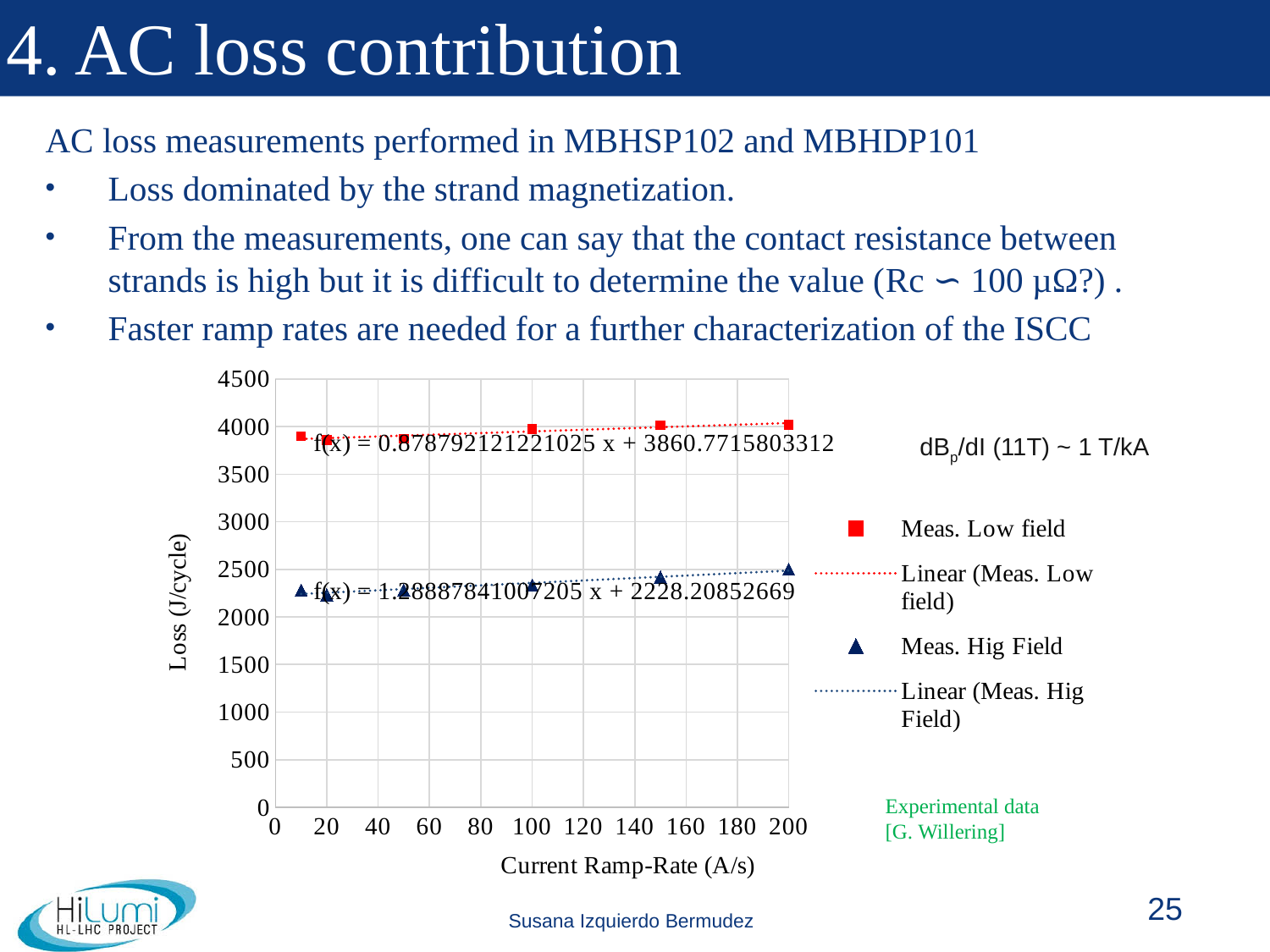
At a current ramp-rate of 200 A/s, which series has the higher loss, Meas. Low field or Meas. Hig Field? Meas. Low field What kind of chart is shown on the slide? scatter chart Do the Meas. Hig Field values rise or fall as the current ramp-rate increases? rise What is the title of the y axis of the chart? Loss (J/cycle) Is the Meas. Low field value at a current ramp-rate of 100 A/s greater or less than 4500? less How many entries does the chart legend list? 4 Is the Meas. Hig Field value at a current ramp-rate of 100 A/s greater or less than 2000? greater Do the Meas. Low field values rise or fall as the current ramp-rate increases? rise Is the Meas. Low field value at a current ramp-rate of 200 A/s greater or less than 3500? greater What is the title of the x axis of the chart? Current Ramp-Rate (A/s)